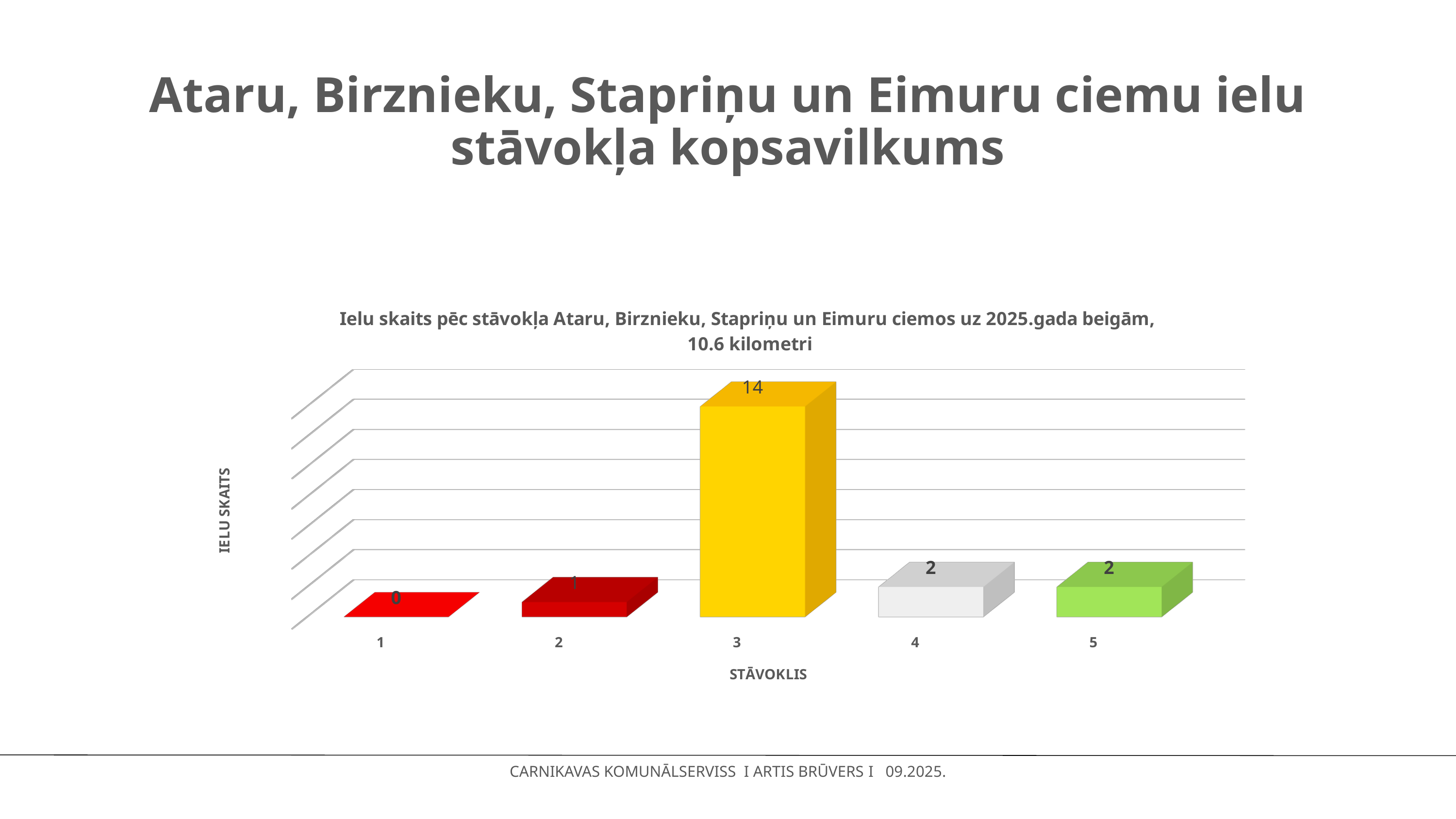
Which category has the lowest value? 1 How many categories are shown on the x axis of the chart? 5 What is the value for category 5 (stāvoklis 5)? 2 What is the value for category 1 (stāvoklis 1)? 0 Which category has the highest value? 3 What is the difference between the value for category 3 and the value for category 4? 12 Which is larger, the value for category 3 or the value for category 5? category 3 What is the title of the x axis? STĀVOKLIS What is the title of the y axis? IELU SKAITS What is the value for category 3 (stāvoklis 3)? 14 What is the value for category 4 (stāvoklis 4)? 2 What type of chart is shown on the slide? bar chart